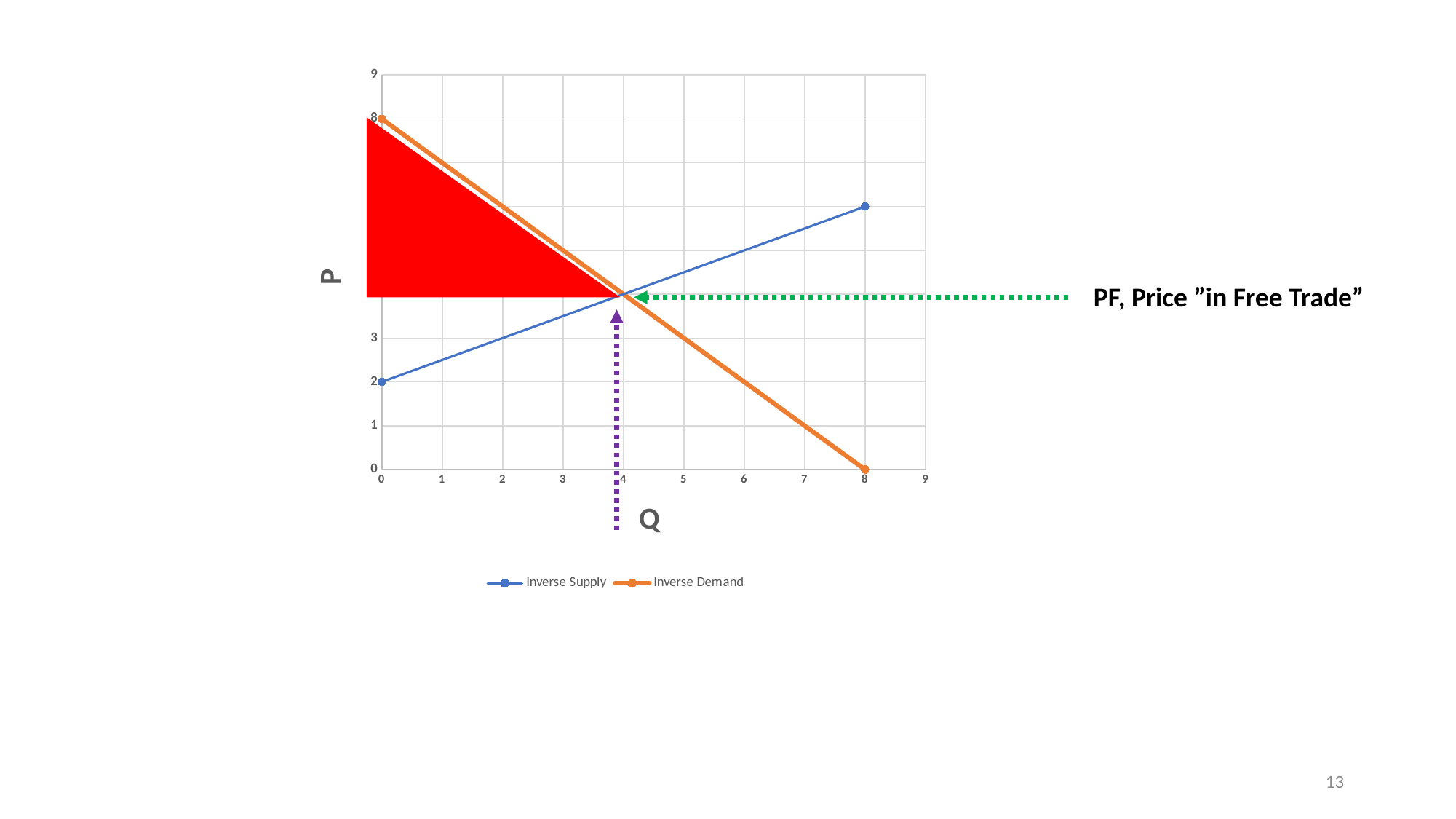
Does the Inverse Supply line rise or fall as Q increases? rise What is the value of Inverse Demand at Q = 0? 8 What is the value of Inverse Supply at Q = 0? 2 What kind of chart is shown on the slide? line chart At what value of Q do the Inverse Supply and Inverse Demand lines intersect? 4 At Q = 0, what is the difference between the Inverse Demand value and the Inverse Supply value? 6 At Q = 0, which series has the higher value, Inverse Supply or Inverse Demand? Inverse Demand How many series does the legend list? 2 Is the value of Inverse Supply at Q = 8 greater or less than 3? greater What is the value of Inverse Demand at Q = 8? 0 What are the two series named in the legend? Inverse Supply and Inverse Demand Does the Inverse Demand line rise or fall as Q increases? fall